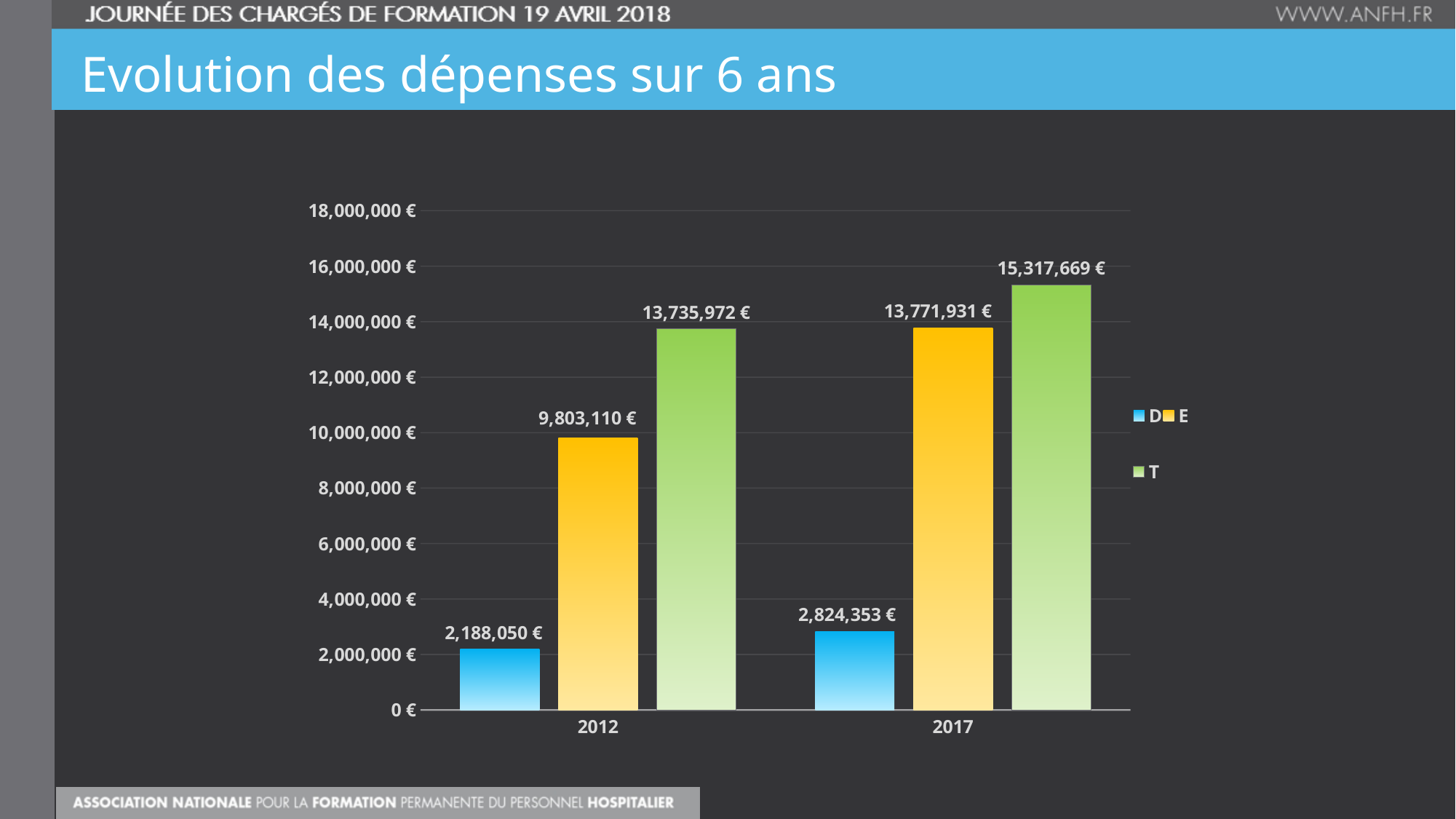
Which series has the lowest value in 2012? D Does the value of series D rise or fall from 2012 to 2017? Rise What is the value of series T in 2012? 13,735,972 € Which is larger: series E in 2012 or series T in 2012? T in 2012 By how much did series T increase from 2012 to 2017? 1,581,697 € What kind of chart is shown on the slide? Bar chart What is the difference between series E in 2017 and series E in 2012? 3,968,821 € Which series has the highest value in 2017? T What is the value of series D in 2017? 2,824,353 € How many series does the legend list? 3 What is the value of series D in 2012? 2,188,050 € What is the value of series E in 2017? 13,771,931 €